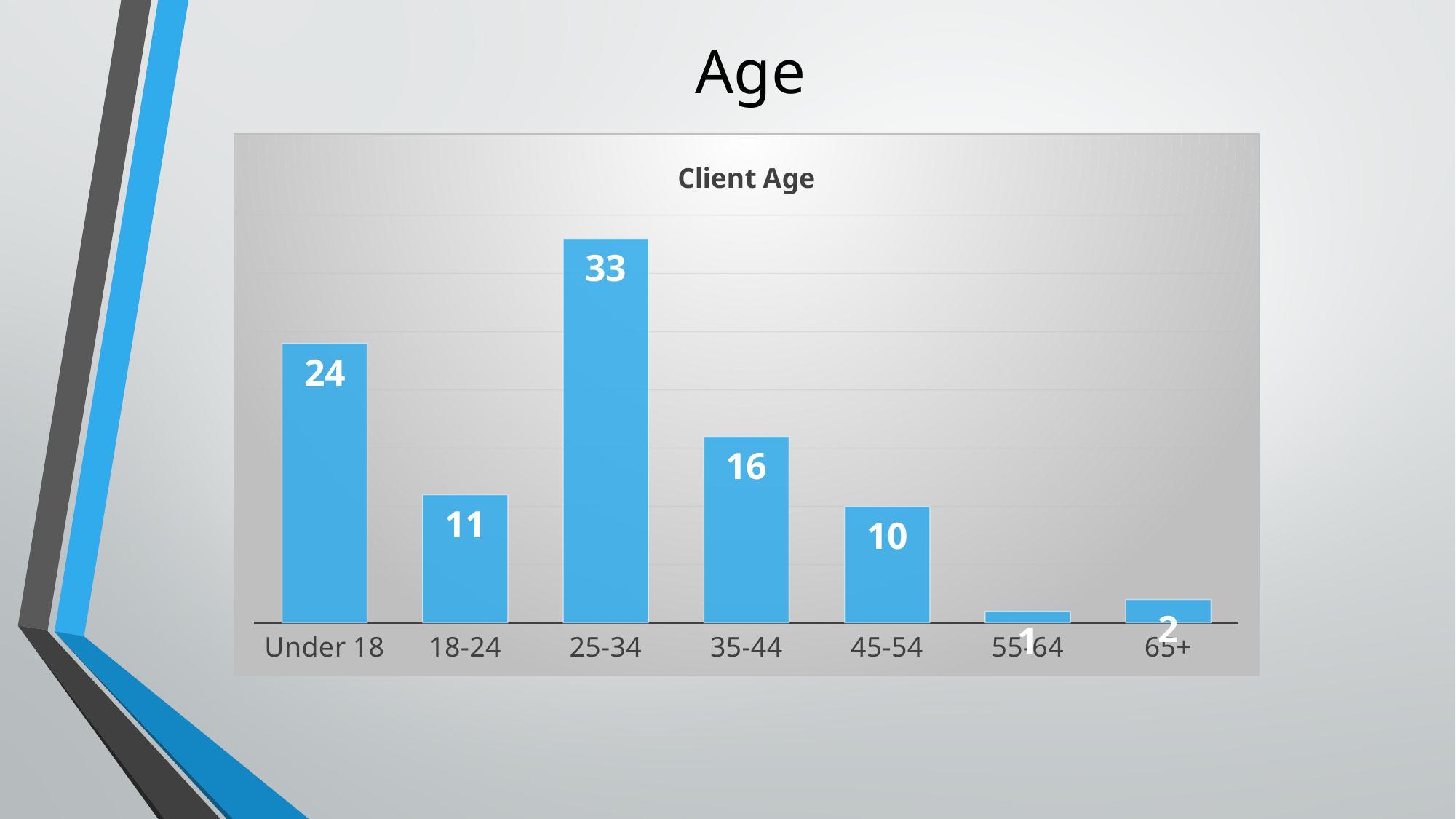
What is the value for the 25-34 age group? 33 How many age groups are shown on the chart? 7 What colour are the bars in the chart? Blue Which age group has the lowest value? 55-64 What is the value for the 45-54 age group? 10 Which is larger, the value for 18-24 or the value for 35-44? 35-44 What is the difference between the values for 25-34 and Under 18? 9 What is the value for the Under 18 age group? 24 What kind of chart is shown on the slide? Bar chart What is the difference between the values for 35-44 and 18-24? 5 Which age group has the highest value? 25-34 What is the title of the chart? Client Age